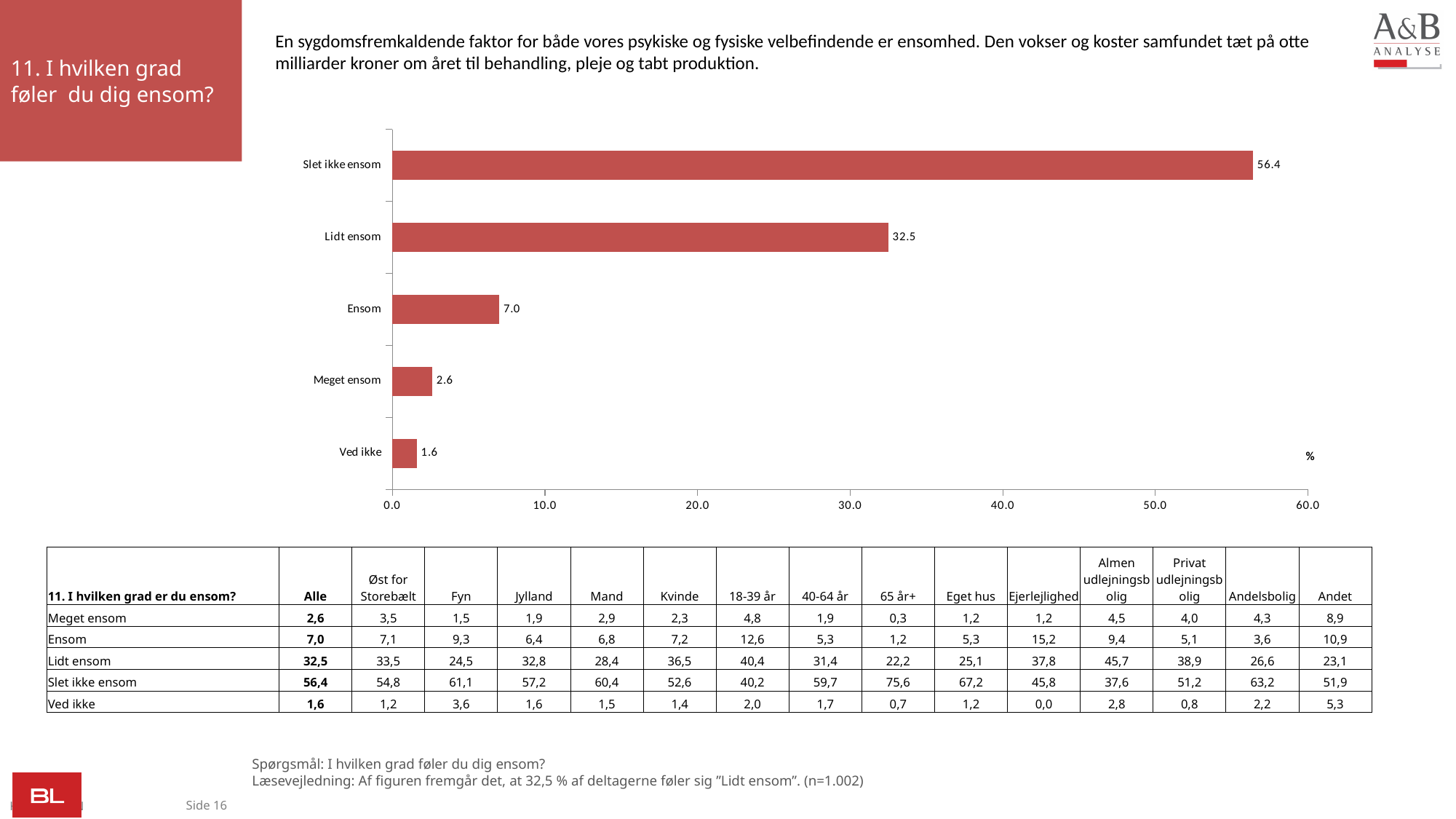
What is the value for "Meget ensom"? 2.6 Which category has the highest value? Slet ikke ensom What kind of chart is shown on the slide? bar chart What is the difference between the values for "Slet ikke ensom" and "Lidt ensom"? 23.9 Which category has the lowest value? Ved ikke Which is larger, the value for "Ensom" or the value for "Meget ensom"? Ensom What is the value for "Ensom"? 7.0 Is the value for "Lidt ensom" greater or less than 30.0? greater What is the value for "Lidt ensom"? 32.5 What is the maximum value shown on the x axis of the chart? 60.0 What is the value for "Slet ikke ensom"? 56.4 How many categories are shown in the bar chart? 5